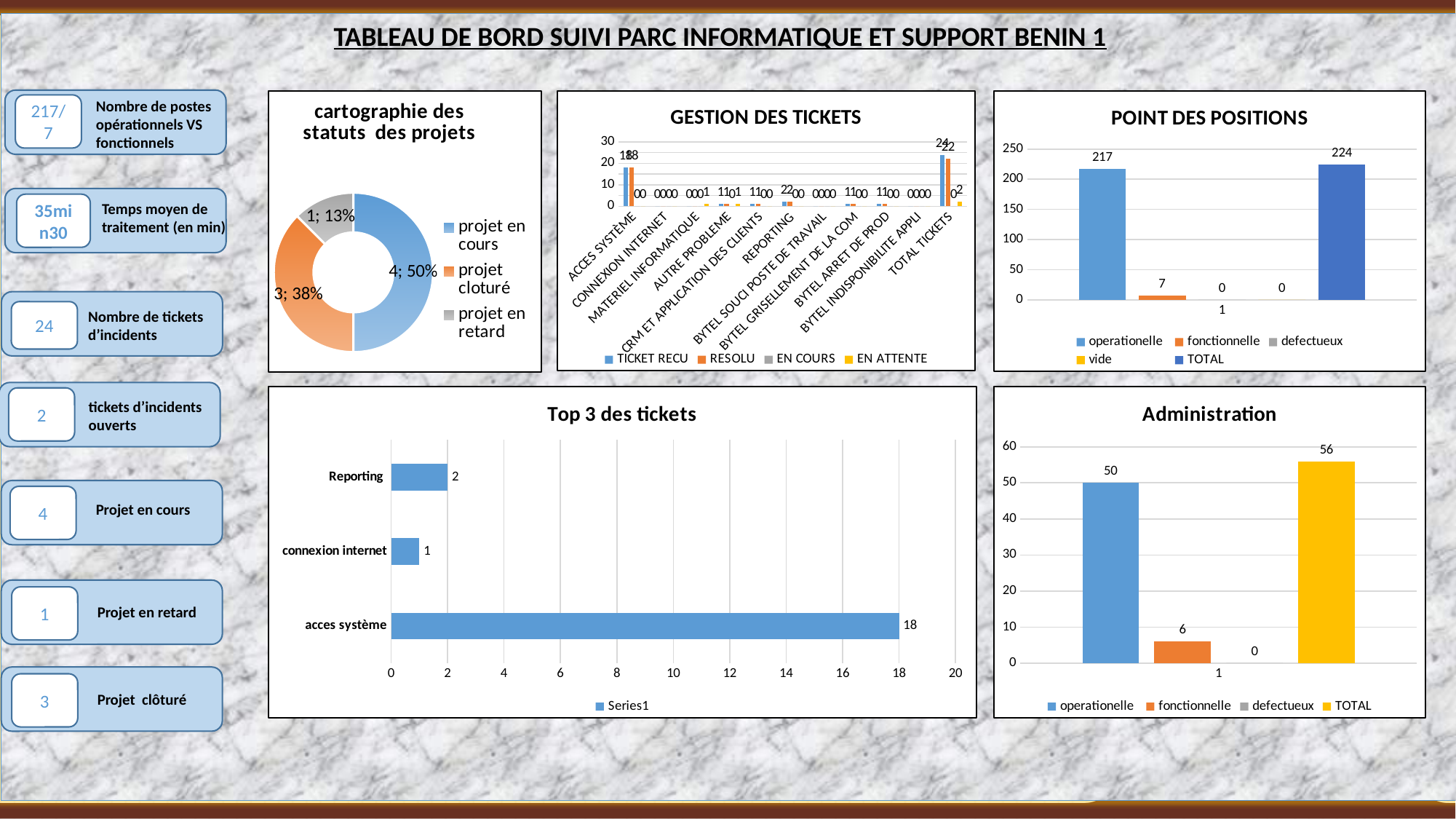
In the 'GESTION DES TICKETS' chart, what is the TICKET RECU value for TOTAL TICKETS? 24 In the 'cartographie des statuts des projets' chart, how many projects are 'projet cloturé'? 3 In the 'POINT DES POSITIONS' chart, what is the difference between TOTAL and operationelle? 7 In the 'Top 3 des tickets' chart, which category has the highest value? acces système In the 'cartographie des statuts des projets' chart, what share of the donut is 'projet en cours'? 50% In the 'Top 3 des tickets' chart, what is the value for Reporting? 2 In the 'GESTION DES TICKETS' chart, how many series does the legend list? 4 What kind of chart is 'Top 3 des tickets'? bar chart In the 'cartographie des statuts des projets' chart, which status has the smallest slice? projet en retard In the 'Administration' chart, which is larger, operationelle or fonctionnelle? operationelle In the 'POINT DES POSITIONS' chart, is the value for TOTAL greater or less than 200? greater In the 'POINT DES POSITIONS' chart, what is the value for operationelle? 217